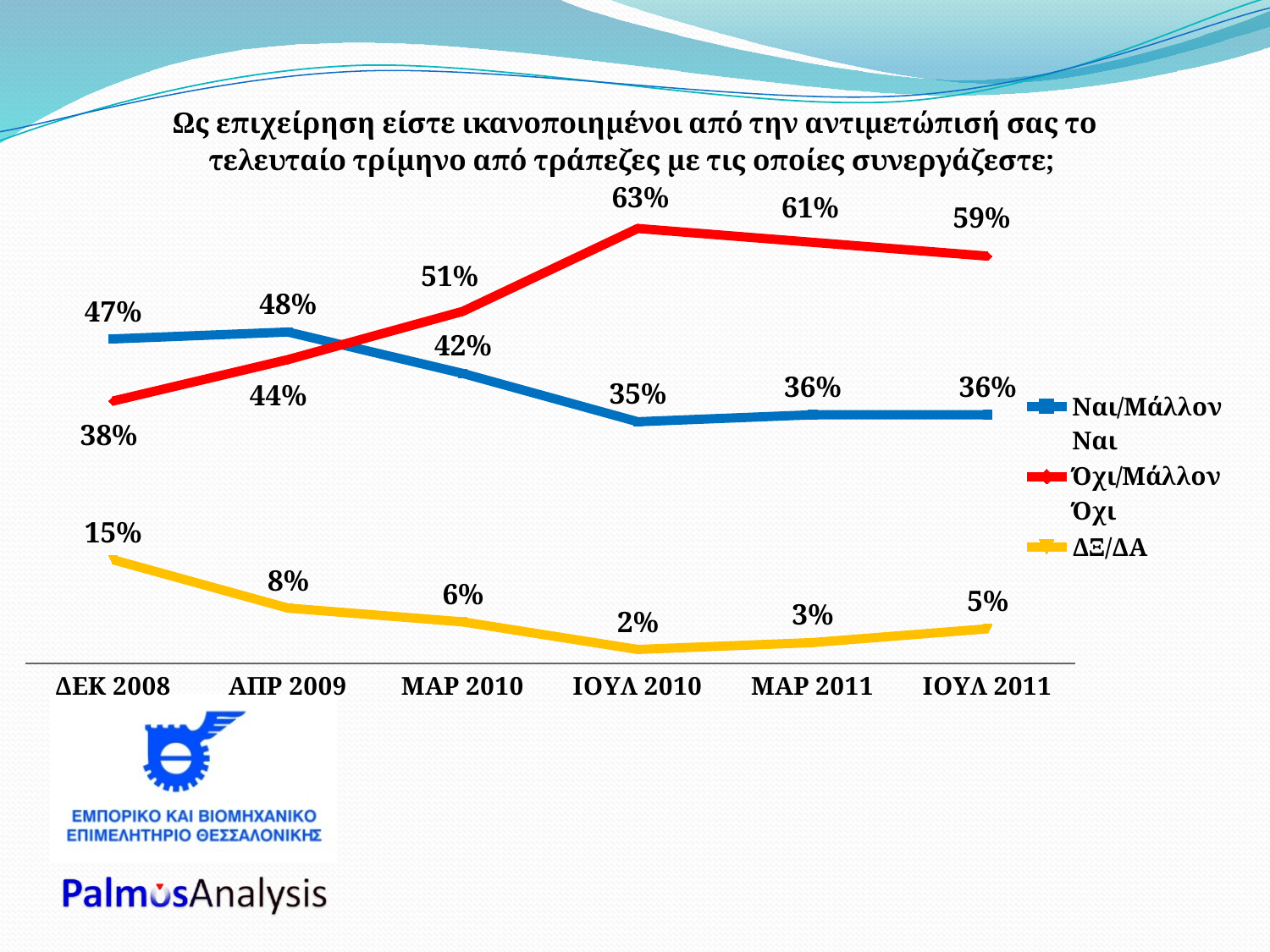
In which period is ΔΞ/ΔΑ at its lowest value? ΙΟΥΛ 2010 How many time points are shown on the x axis? 6 What is the value for Όχι/Μάλλον Όχι in ΙΟΥΛ 2010? 63% How many series does the legend list? 3 What is the value for ΔΞ/ΔΑ in ΜΑΡ 2011? 3% Does the Όχι/Μάλλον Όχι series rise or fall from ΔΕΚ 2008 to ΙΟΥΛ 2010? rise What is the difference between Όχι/Μάλλον Όχι and Ναι/Μάλλον Ναι in ΙΟΥΛ 2011? 23% Which series has the larger value in ΑΠΡ 2009, Ναι/Μάλλον Ναι or Όχι/Μάλλον Όχι? Ναι/Μάλλον Ναι What type of chart is shown on the slide? line chart What colour is the line for ΔΞ/ΔΑ? yellow What is the value for Ναι/Μάλλον Ναι in ΔΕΚ 2008? 47% In which period does Όχι/Μάλλον Όχι reach its highest value? ΙΟΥΛ 2010